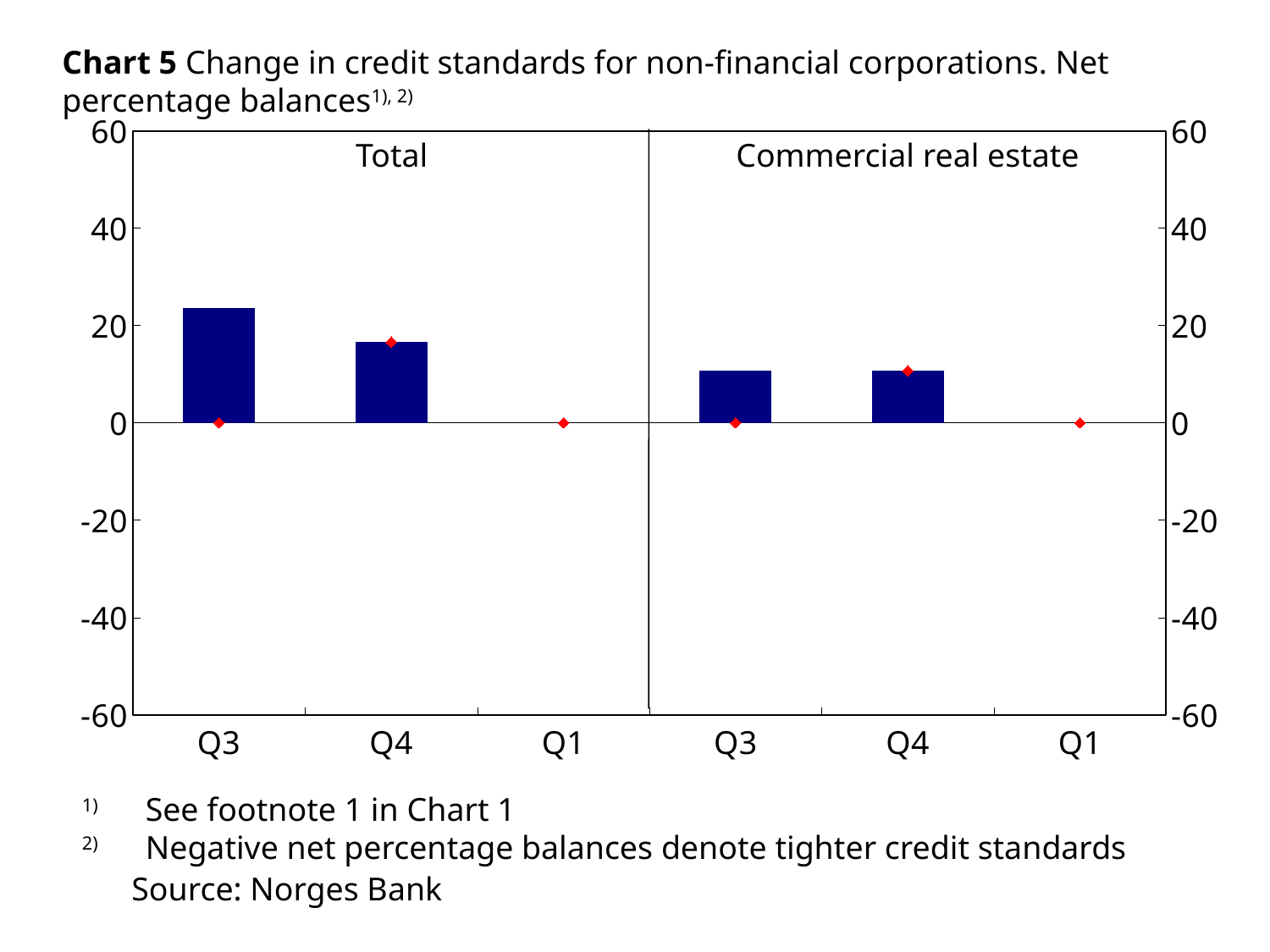
In the Commercial real estate panel, is the value for Q4 greater or less than 0? greater Which bar is taller: Total Q4 or Commercial real estate Q4? Total Q4 In the Total panel, is the value for Q4 greater or less than 20? less What kind of chart is shown on the slide? bar chart What are the two panels of the chart labelled? Total and Commercial real estate In the Total panel, which quarter has the highest bar? Q3 How many quarter labels are shown along the x axis in total? 6 Which bar is taller: Total Q3 or Commercial real estate Q3? Total Q3 In the Total panel, is the value for Q3 greater or less than 20? greater In the Total panel, do the bars rise or fall from Q3 to Q4? fall What is the maximum value shown on the vertical axis? 60